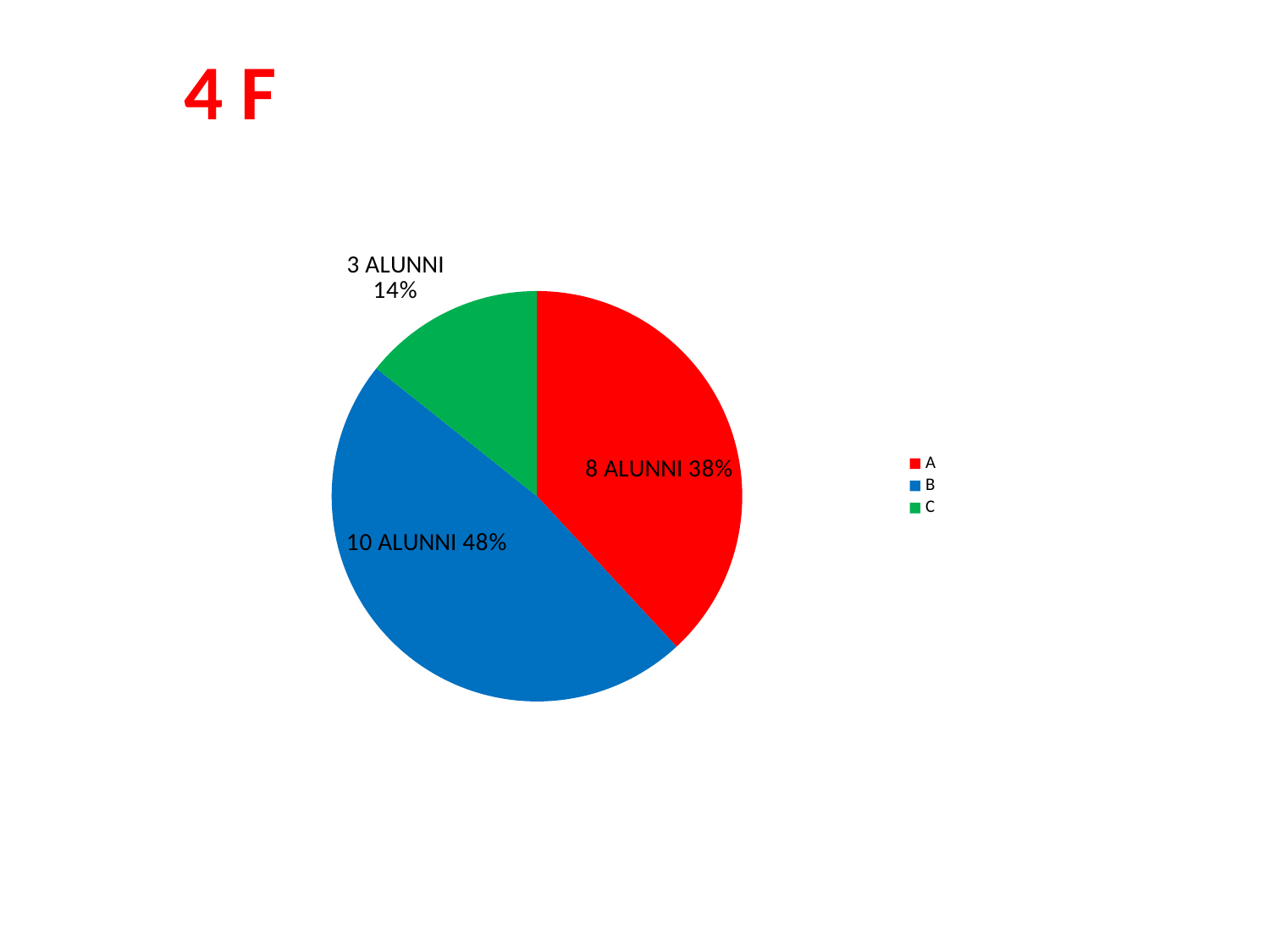
What share of the pie does slice A represent? 38% What share of the pie does slice C represent? 14% How many entries does the legend list? 3 Which category has the largest slice? B How many alunni are in category B? 10 ALUNNI What kind of chart is shown on the slide? pie chart What is the difference in percentage points between slice B and slice A? 10 Which colour represents category C in the legend? green What share of the pie does slice B represent? 48% How many slices does the pie chart have? 3 Which category has the smallest slice? C How many alunni are in category C? 3 ALUNNI